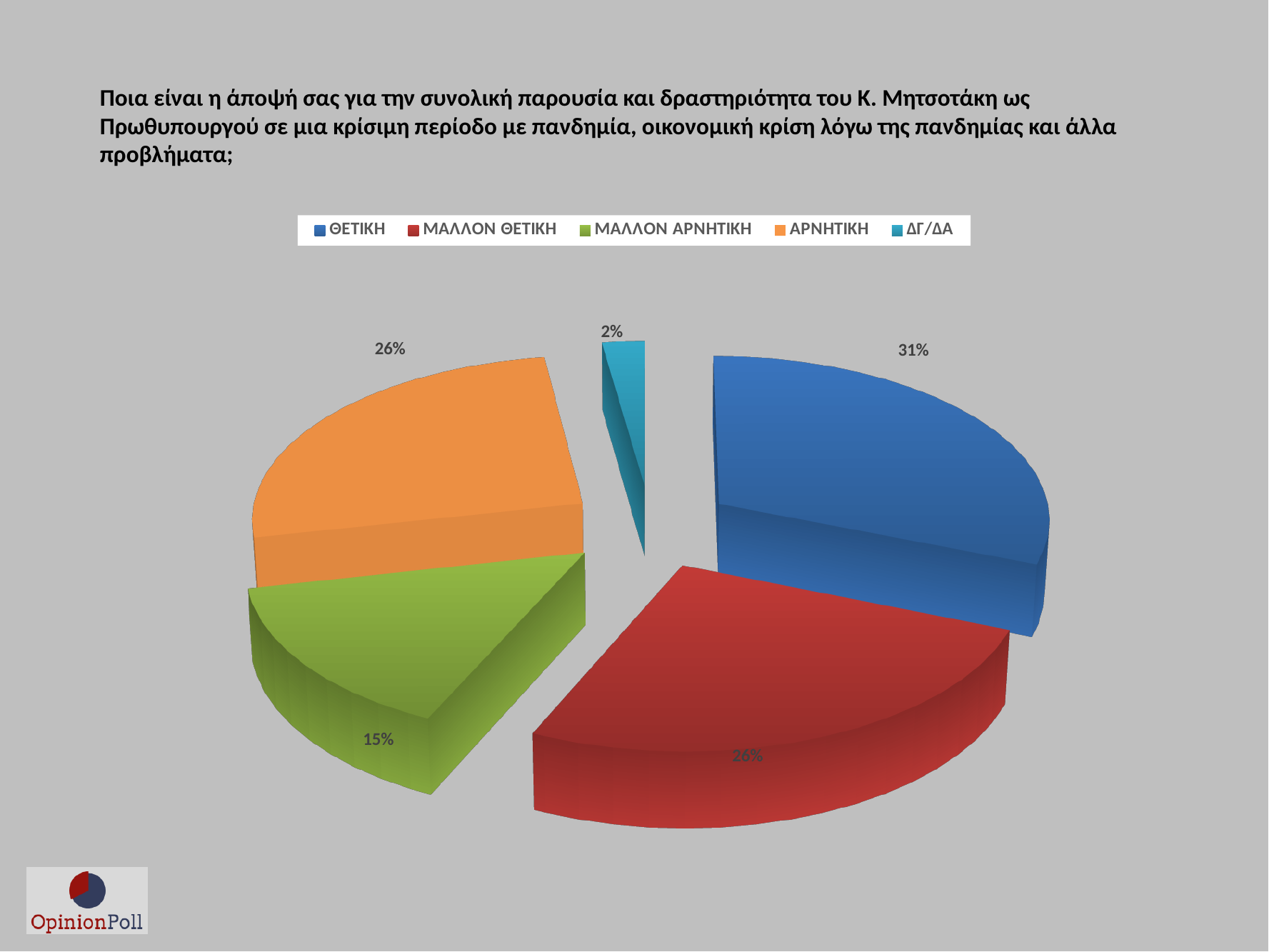
Which category has the largest slice of the pie? ΘΕΤΙΚΗ What kind of chart is shown on the slide? pie chart What is the value for ΔΓ/ΔΑ? 2% Which category has the smallest slice of the pie? ΔΓ/ΔΑ Which is larger, ΘΕΤΙΚΗ or ΜΑΛΛΟΝ ΑΡΝΗΤΙΚΗ? ΘΕΤΙΚΗ What share of the pie does ΘΕΤΙΚΗ have? 31% What is the value for ΜΑΛΛΟΝ ΘΕΤΙΚΗ? 26% What is the value for ΜΑΛΛΟΝ ΑΡΝΗΤΙΚΗ? 15% How many categories does the pie chart have? 5 What is the value for ΑΡΝΗΤΙΚΗ? 26% What is the difference in percentage points between ΘΕΤΙΚΗ and ΜΑΛΛΟΝ ΑΡΝΗΤΙΚΗ? 16 What colour is the ΑΡΝΗΤΙΚΗ slice? orange